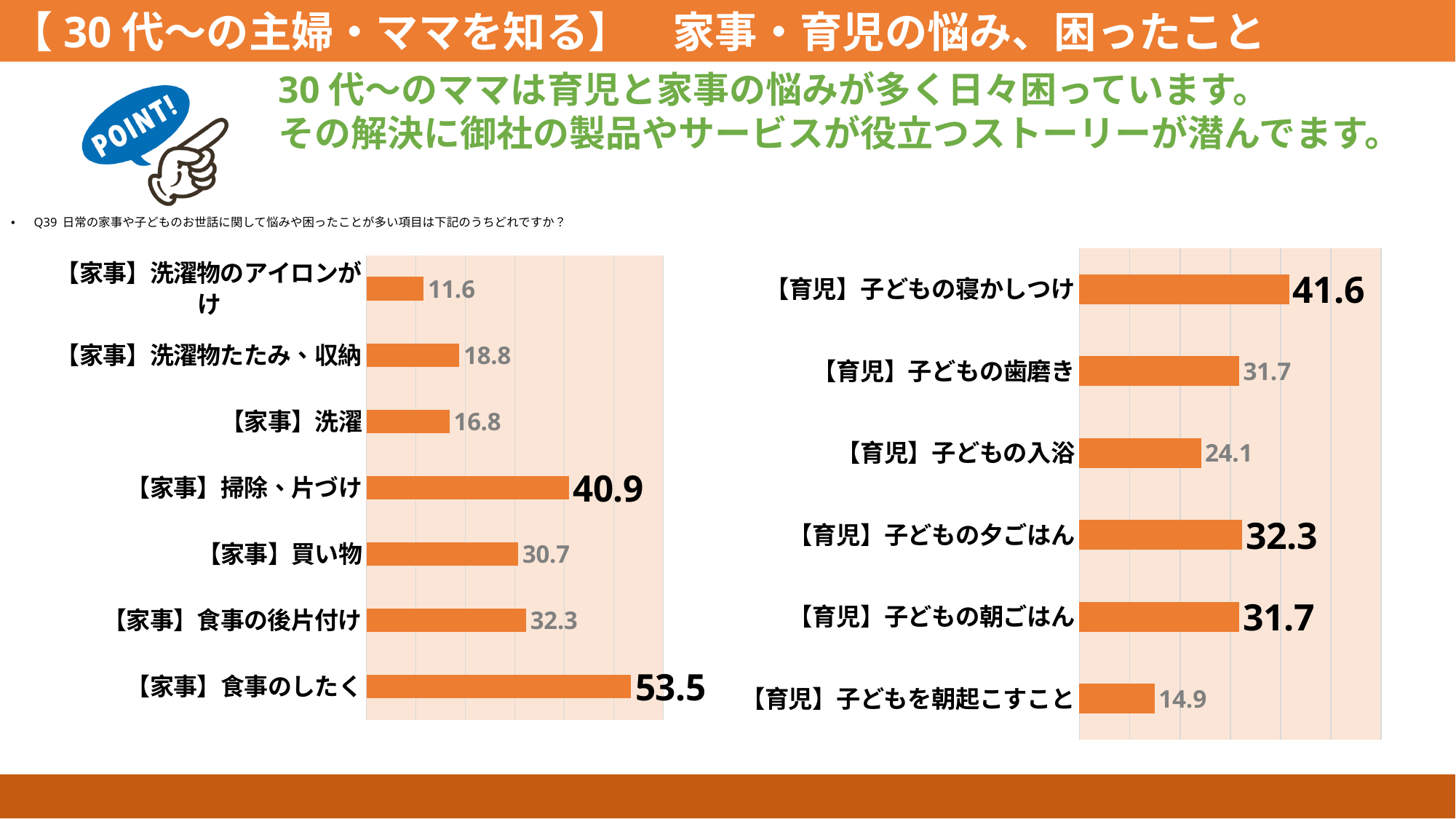
In the left chart (家事), what is the value for 【家事】食事のしたく? 53.5 In the right chart (育児), which category has the highest value? 【育児】子どもの寝かしつけ In the right chart (育児), what is the value for 【育児】子どもの入浴? 24.1 In the right chart (育児), what is the value for 【育児】子どもの寝かしつけ? 41.6 In the left chart (家事), which is larger: 【家事】洗濯物たたみ、収納 or 【家事】洗濯? 【家事】洗濯物たたみ、収納 In the left chart (家事), how many categories are shown? 7 What type of chart is the right chart (育児)? Bar chart In the right chart (育児), which category has the lowest value? 【育児】子どもを朝起こすこと In the left chart (家事), which category has the lowest value? 【家事】洗濯物のアイロンがけ In the right chart (育児), what is the difference between 【育児】子どもの夕ごはん and 【育児】子どもの朝ごはん? 0.6 In the left chart (家事), what is the difference between 【家事】食事のしたく and 【家事】掃除、片づけ? 12.6 In the left chart (家事), what is the value for 【家事】掃除、片づけ? 40.9